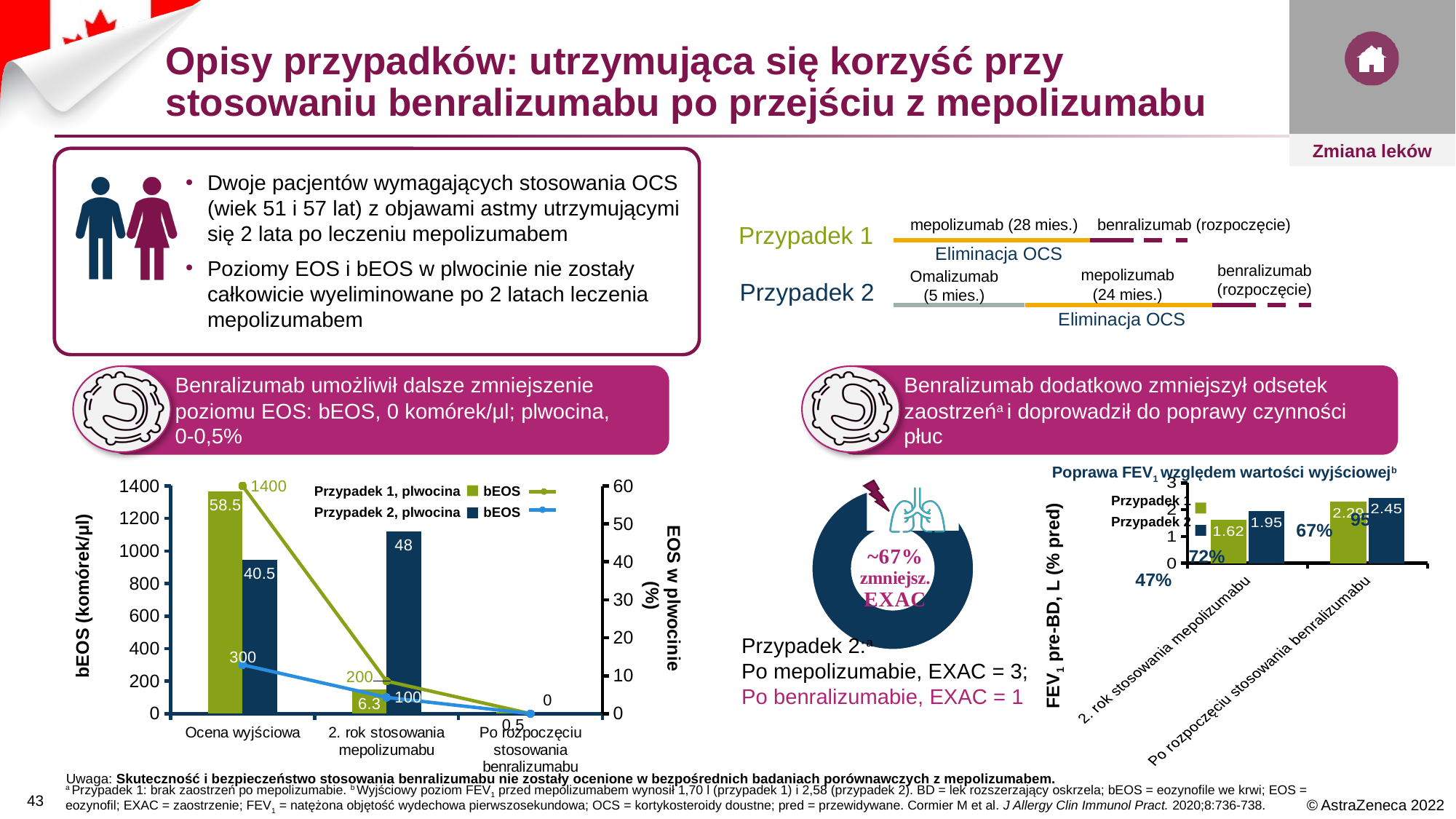
In the 'Poprawa FEV1 względem wartości wyjściowej' chart, what is the difference between the Przypadek 1 values at 'Po rozpoczęciu stosowania benralizumabu' and '2. rok stosowania mepolizumabu'? 0.67 How many categories are on the x axis of the bEOS chart on the left of the slide? 3 How many categories are on the x axis of the 'Poprawa FEV1 względem wartości wyjściowej' chart? 2 In the 'Poprawa FEV1 względem wartości wyjściowej' chart, what is the value for Przypadek 2 at 'Po rozpoczęciu stosowania benralizumabu'? 2.45 In the 'Poprawa FEV1 względem wartości wyjściowej' chart, do the Przypadek 1 values rise or fall from '2. rok stosowania mepolizumabu' to 'Po rozpoczęciu stosowania benralizumabu'? rise What is the title of the left vertical axis of the bEOS chart on the left of the slide? bEOS (komórek/µl) What kind of chart is the 'Poprawa FEV1 względem wartości wyjściowej' chart on the right? bar chart In the 'Poprawa FEV1 względem wartości wyjściowej' chart, which case has the higher value at '2. rok stosowania mepolizumabu', Przypadek 1 or Przypadek 2? Przypadek 2 In the bEOS chart on the left of the slide, what value is printed on the green (Przypadek 1) bar at 'Ocena wyjściowa'? 58.5 How many series does the legend of the 'Poprawa FEV1 względem wartości wyjściowej' chart list? 2 In the 'Poprawa FEV1 względem wartości wyjściowej' chart, what is the difference between the Przypadek 2 values at 'Po rozpoczęciu stosowania benralizumabu' and '2. rok stosowania mepolizumabu'? 0.50 In the 'Poprawa FEV1 względem wartości wyjściowej' chart, what is the value for Przypadek 1 at '2. rok stosowania mepolizumabu'? 1.62